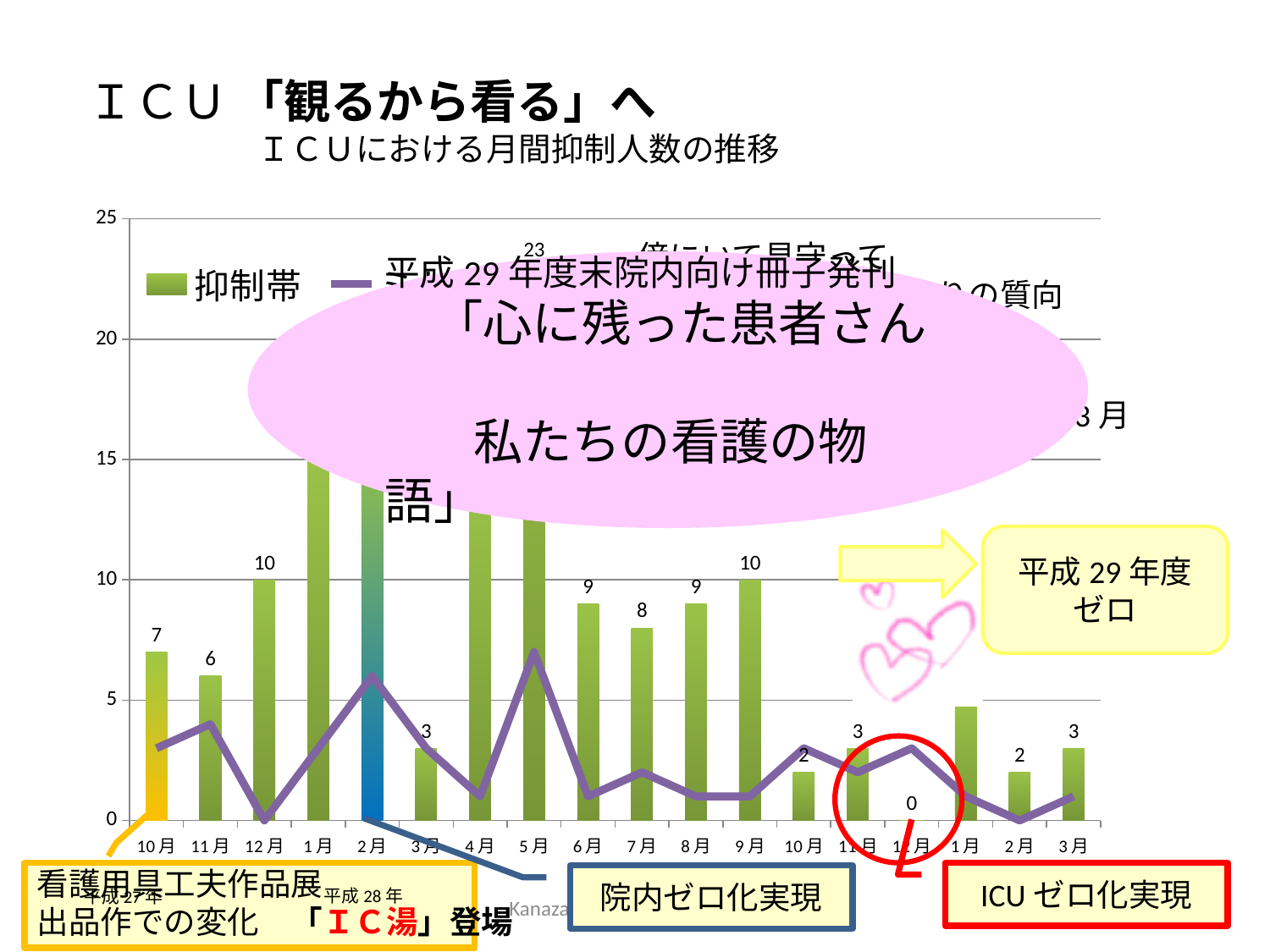
How many entries does the chart legend list? 2 Which month has the lowest 抑制帯 value? 12月 (the second 12月, value 0) What is the first entry in the chart legend? 抑制帯 What kind of chart is used to show the 抑制帯 values? bar chart What is the 抑制帯 value for the first 10月 (leftmost bar)? 7 What is the difference between the 抑制帯 values for the first 10月 (7) and the first 11月 (6)? 1 What is the 抑制帯 value for 7月? 8 How many month categories are shown on the x axis? 18 Is the 抑制帯 value for the second 1月 (near the right end) greater or less than 10? less What is the title of the chart? ＩＣＵにおける月間抑制人数の推移 Which has the larger 抑制帯 value, 6月 or 7月? 6月 What is the 抑制帯 value for 9月? 10